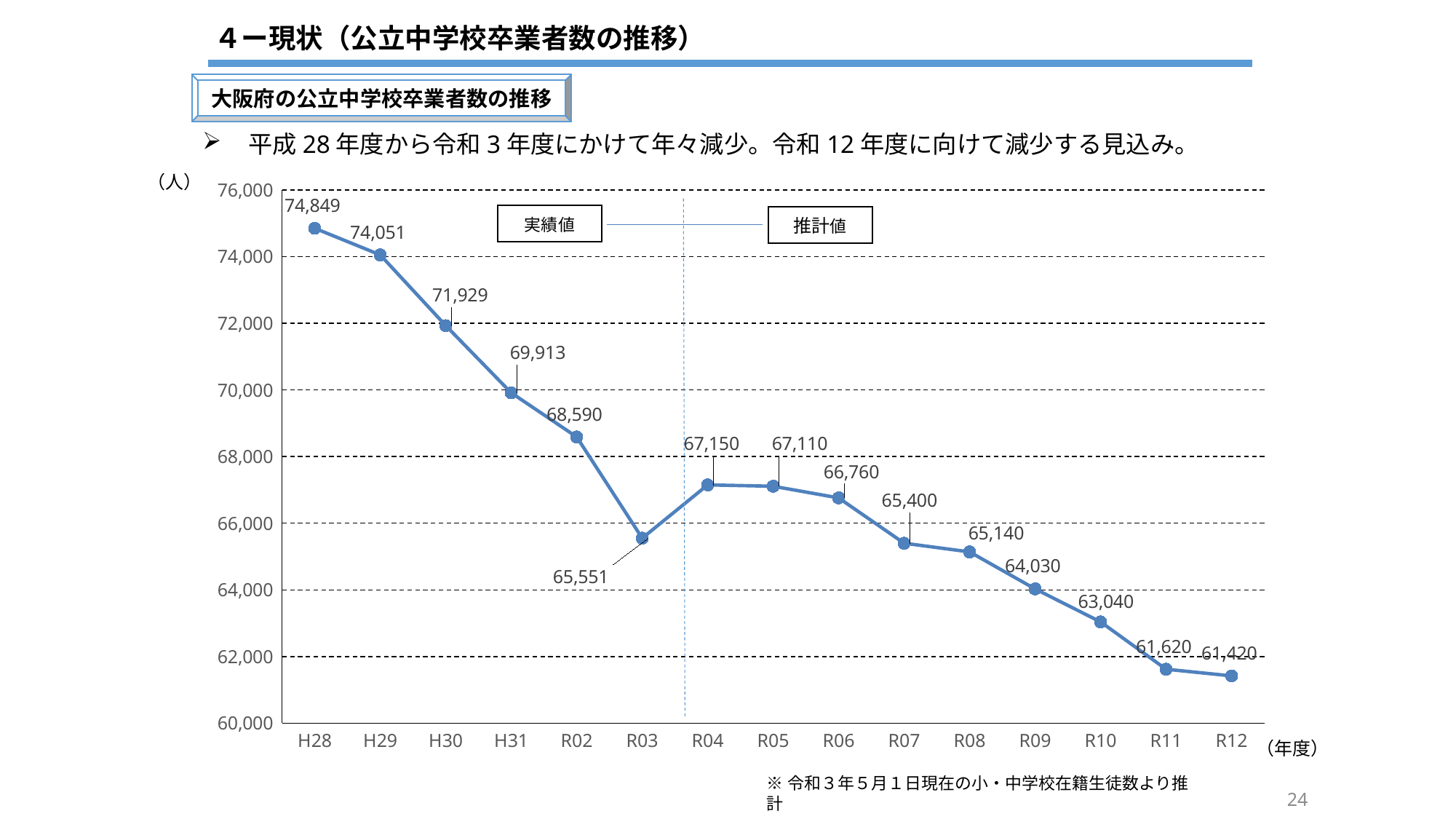
What is the value for R03? 65,551 What is the value for H28? 74,849 Which year has the lowest value? R12 Which year has the highest value? H28 What is the difference between the values for R03 and R04? 1,599 Which is larger, the value for H30 or the value for R04? H30 What is the value for R06? 66,760 What is the difference between the values for H28 and R12? 13,429 What is the value for R12? 61,420 What type of chart is shown on the slide? line chart Overall, do the values rise or fall from H28 to R12? fall How many data points are plotted on the chart? 15